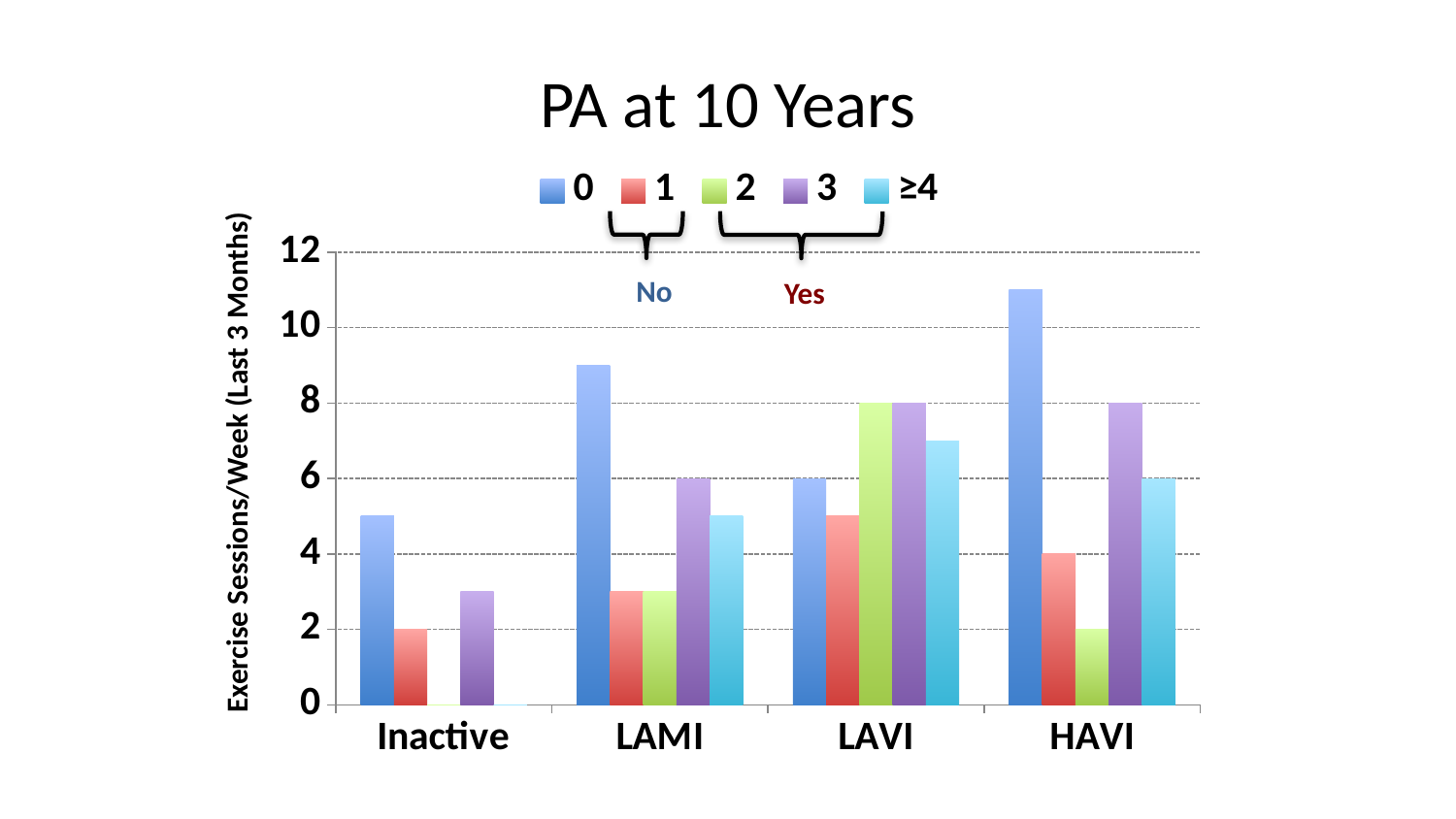
Which category has the lowest value for series 0? Inactive Is the value for series 0 in the HAVI category greater or less than 10? greater How many categories are shown on the x axis? 4 Which category has the highest value for series 0? HAVI What is the value for series 1 in the Inactive category? 2 What is the title of the chart? PA at 10 Years Which is larger: the value for series 0 in LAMI or the value for series 0 in LAVI? LAMI How many series does the legend list? 5 What is the difference between the value for series 2 and the value for series 0 in the LAVI category? 2 What type of chart is shown on the slide? bar chart What is the value for series 3 in the LAVI category? 8 What is the value for series ≥4 in the HAVI category? 6